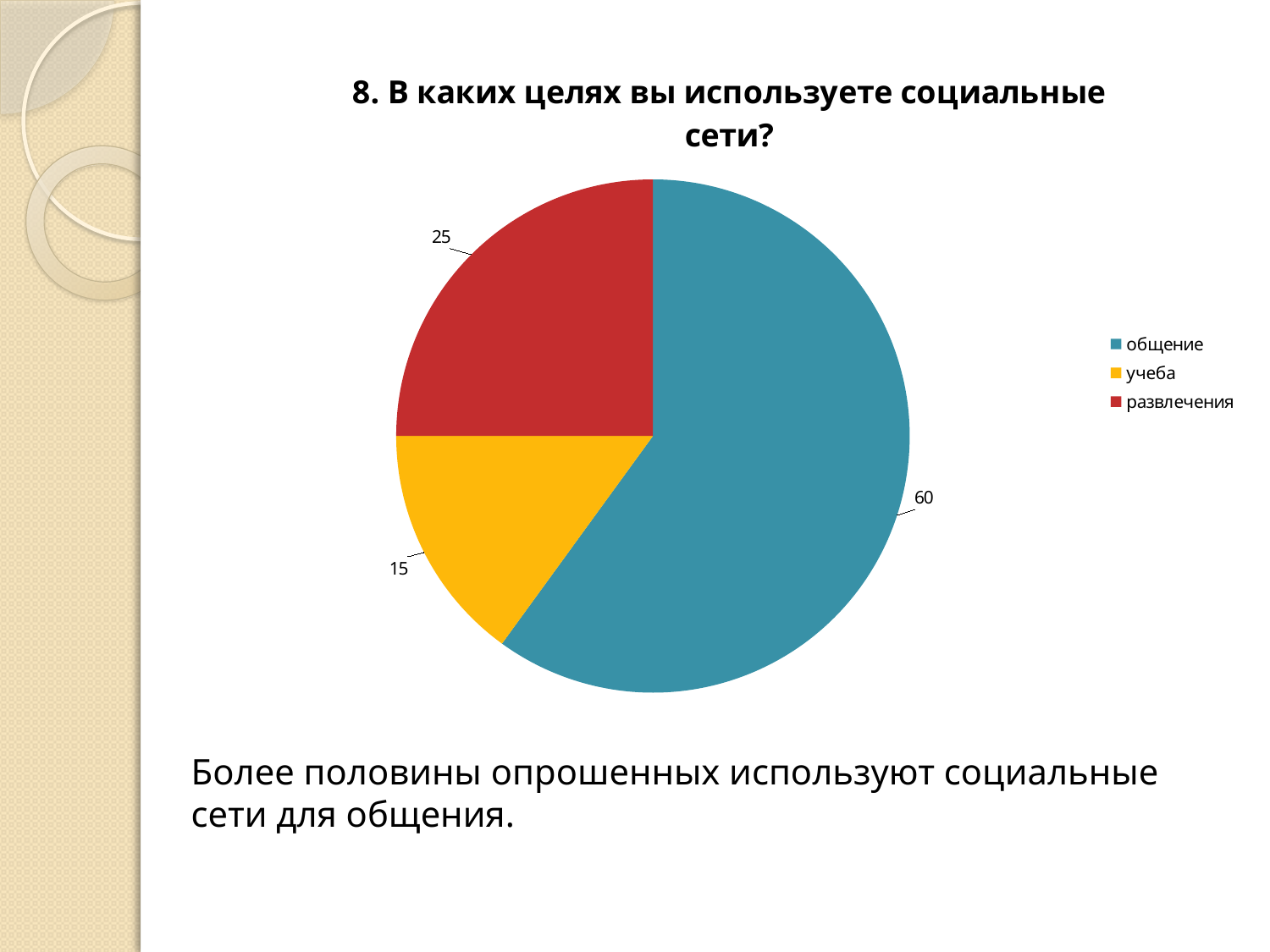
What is the difference between the values for общение and развлечения? 35 What is the title of the chart? 8. В каких целях вы используете социальные сети? What is the difference between the values for развлечения and учеба? 10 What is the value for учеба? 15 Which category has the largest slice? общение What is the value for развлечения? 25 How many categories does the pie chart have? 3 What share of the pie does общение represent? 60% Which category has the smallest slice? учеба Which is larger, the value for развлечения or the value for учеба? развлечения What is the value for общение? 60 What type of chart is shown on the slide? pie chart